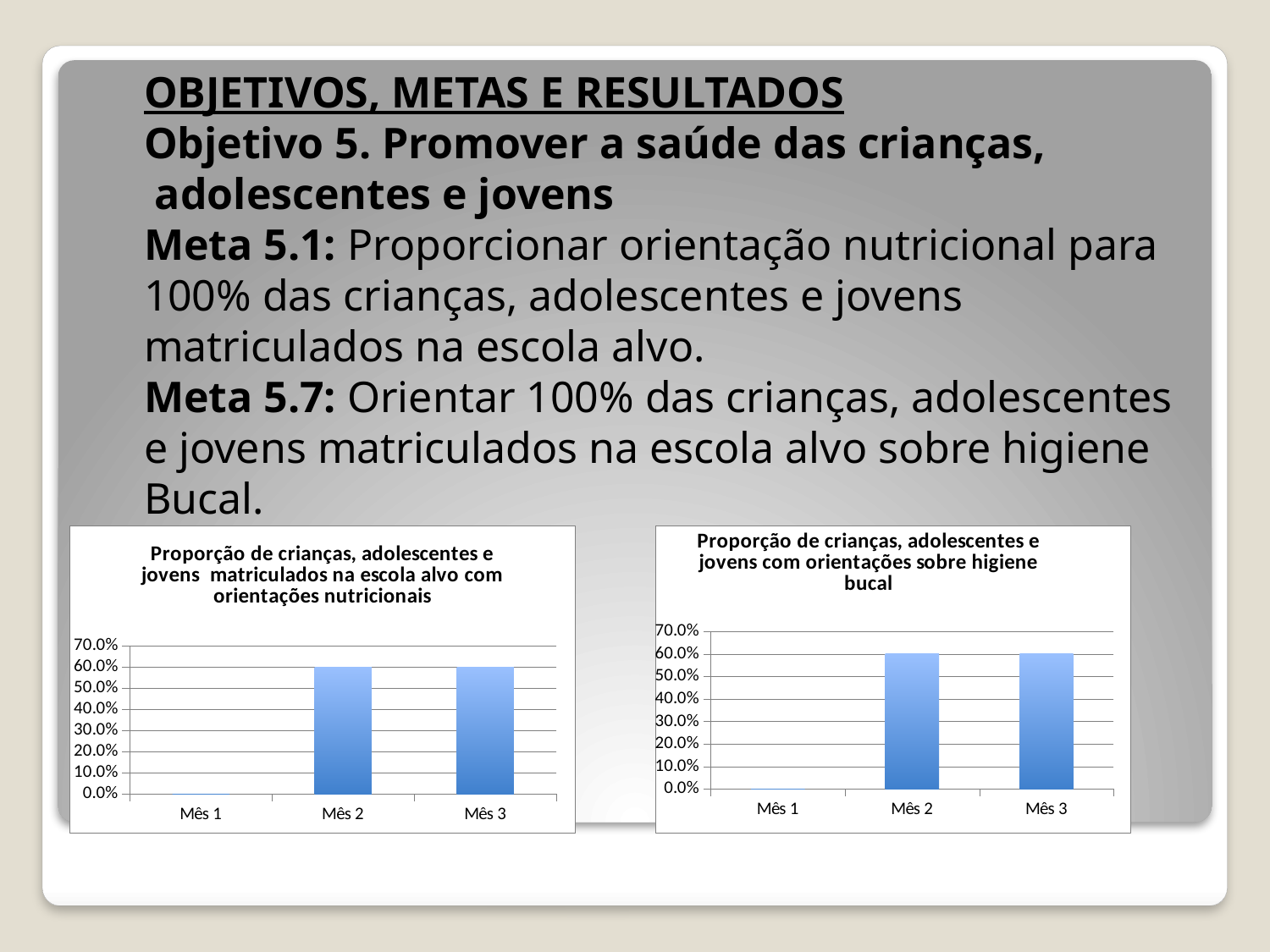
In the left chart (orientações nutricionais), which is larger, the value for Mês 1 or Mês 3? Mês 3 In the left chart (orientações nutricionais), is the value for Mês 1 greater or less than 10.0%? less In the right chart (higiene bucal), which month has the lowest value? Mês 1 In the right chart (higiene bucal), is the value for Mês 2 greater or less than 50.0%? greater What is the highest value shown on the y axis of the left chart (orientações nutricionais)? 70.0% What is the title of the right chart? Proporção de crianças, adolescentes e jovens com orientações sobre higiene bucal In the right chart (higiene bucal), does the value rise or fall from Mês 1 to Mês 2? rise How many months are shown on the x axis of the right chart (higiene bucal)? 3 In the left chart (orientações nutricionais), which month has the lowest value? Mês 1 What kind of chart is the left chart (orientações nutricionais)? bar chart In the left chart (orientações nutricionais), what is the value for Mês 2? 60.0% In the right chart (higiene bucal), what is the value for Mês 3? 60.0%